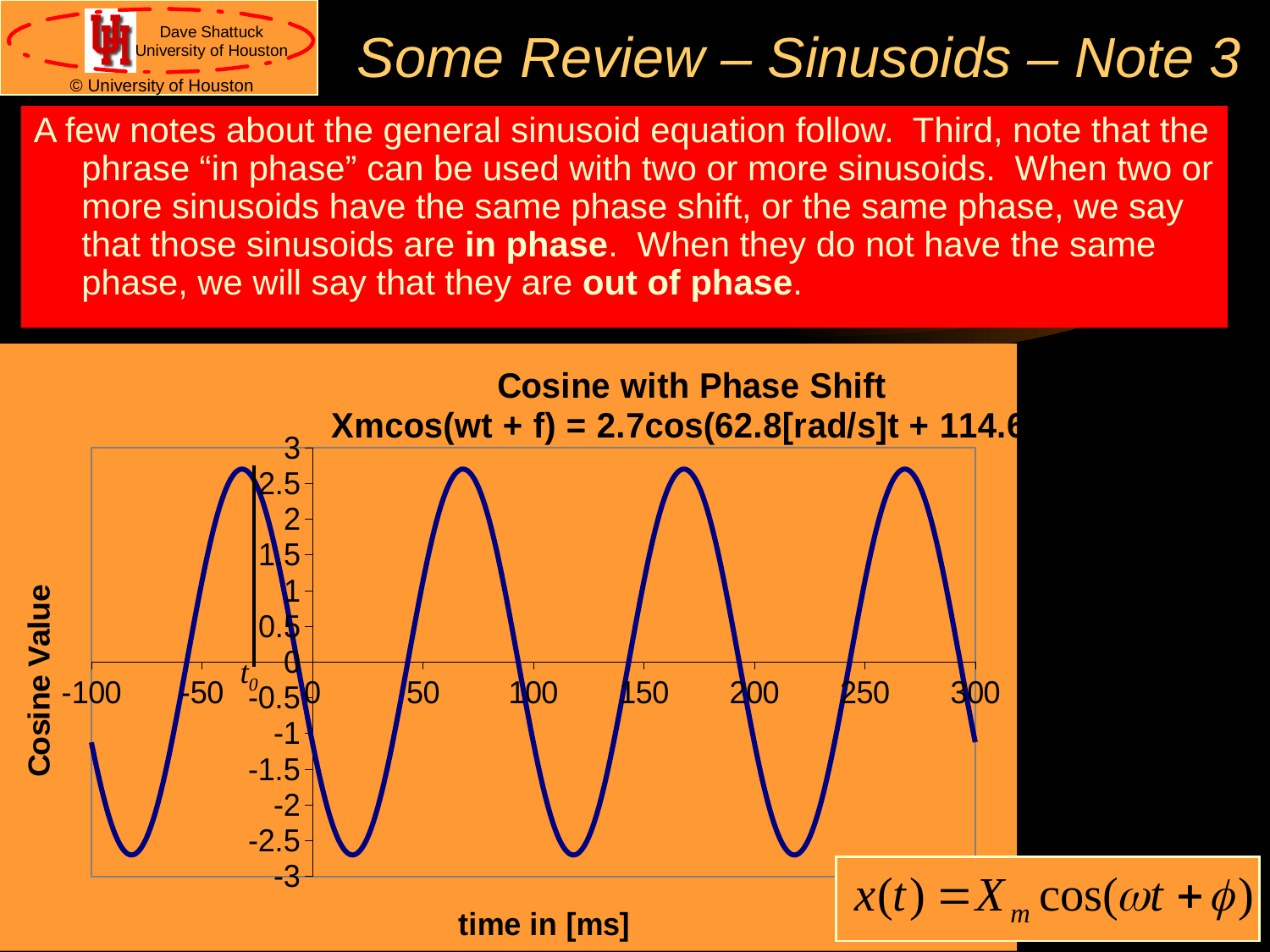
What is the maximum value shown on the x axis of the chart? 300 How many peaks (maxima) of the cosine curve are visible in the plotted range? 4 What is the maximum value shown on the y axis of the chart? 3 What is the title of the chart? Cosine with Phase Shift What is the label of the x axis of the chart? time in [ms] Is the cosine value at time 0 ms greater or less than 0? less What is the minimum value shown on the x axis of the chart? -100 Immediately after time 0 ms, does the cosine curve rise or fall? fall Is the cosine value at time 50 ms greater or less than 0? greater What kind of chart is shown on the slide? line chart Is the cosine value at time 100 ms greater or less than 0? less